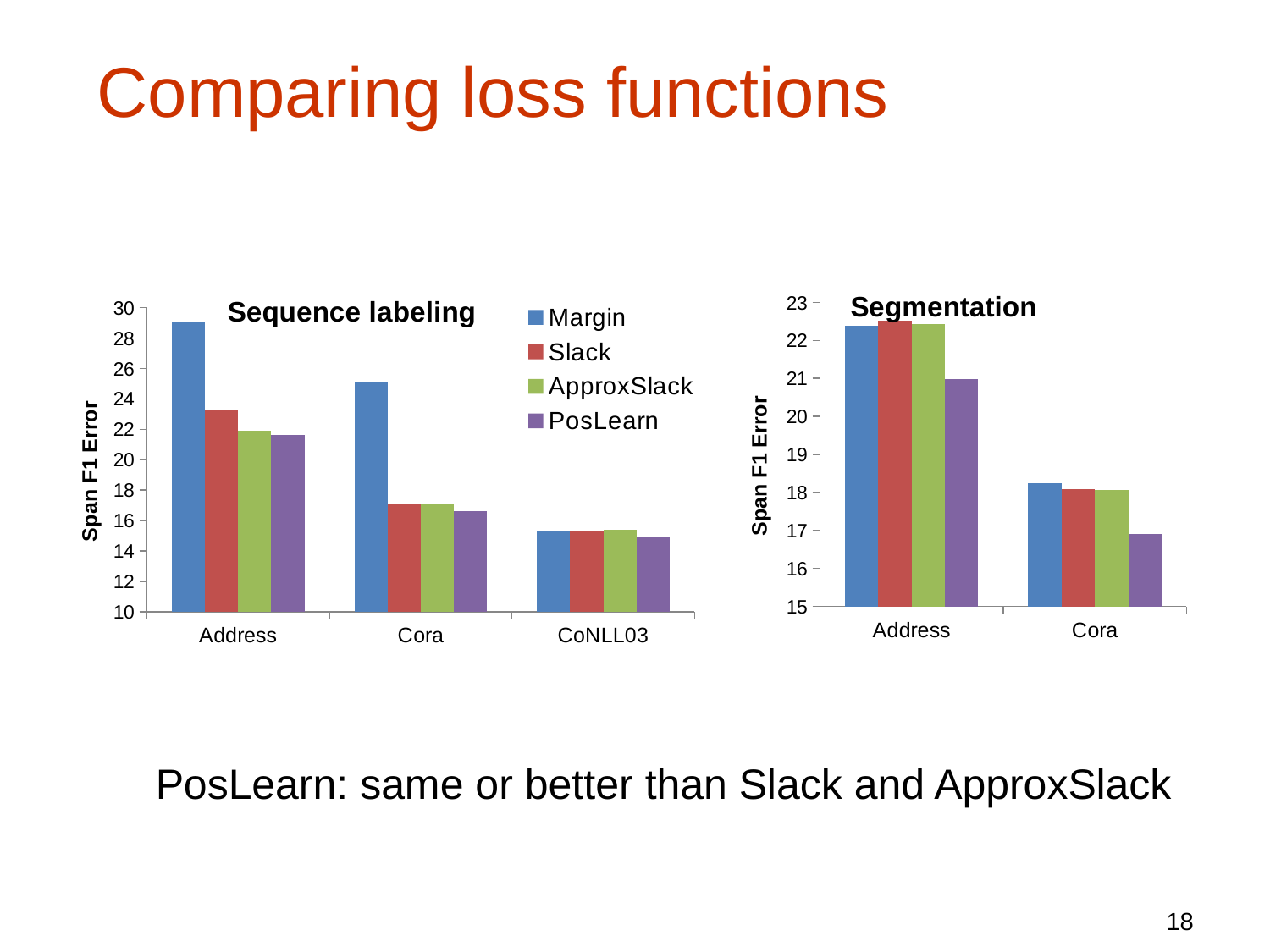
In the Sequence labeling chart, which series has the highest Span F1 Error for Address? Margin What is the y-axis label on the Segmentation chart? Span F1 Error In the Segmentation chart, is the PosLearn value for Address greater or less than 22? less What kind of chart is the Sequence labeling chart? bar chart In the Sequence labeling chart, is the Margin value for Cora greater or less than 24? greater In the Sequence labeling chart, which is larger for Cora: the Margin value or the Slack value? Margin In the Segmentation chart, which is larger for Cora: the Margin value or the PosLearn value? Margin How many categories are shown on the x axis of the Segmentation chart? 2 In the Sequence labeling chart, is the PosLearn value for CoNLL03 greater or less than 16? less How many categories are shown on the x axis of the Sequence labeling chart? 3 In the Segmentation chart, which series has the lowest Span F1 Error for Cora? PosLearn How many series does the legend list on the Sequence labeling chart? 4